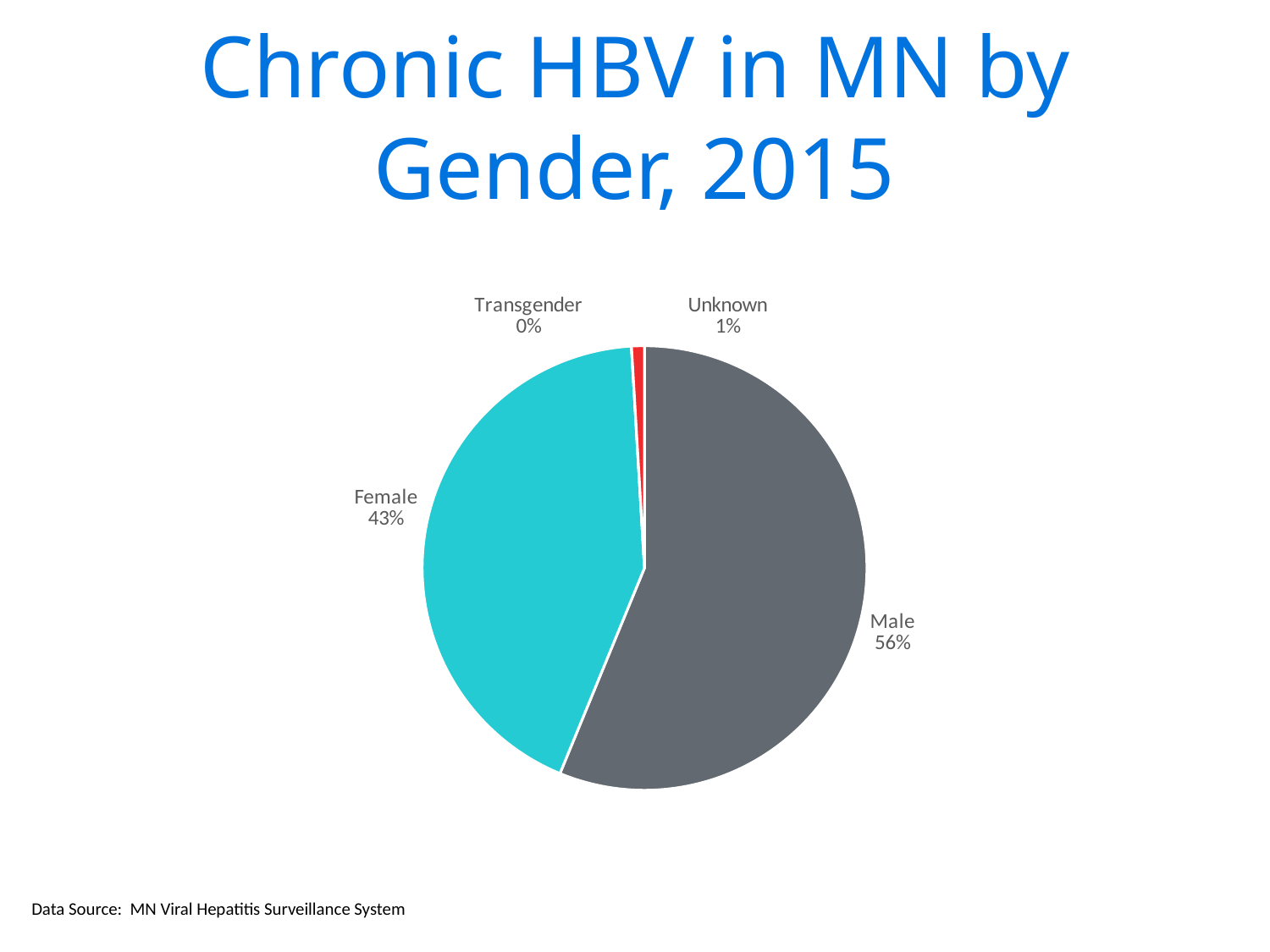
What share of the pie is Female? 43% Which category has the smallest slice of the pie? Transgender How many categories are shown in the pie chart? 4 What percentage is shown for Unknown? 1% Which category has the largest slice of the pie? Male What share of the pie is Male? 56% What is the title of the chart? Chronic HBV in MN by Gender, 2015 Which is larger, the Female share or the Male share? Male What kind of chart is shown on the slide? Pie chart What data source is cited on the slide? MN Viral Hepatitis Surveillance System What percentage is shown for Transgender? 0% What is the difference in percentage points between Male and Female? 13